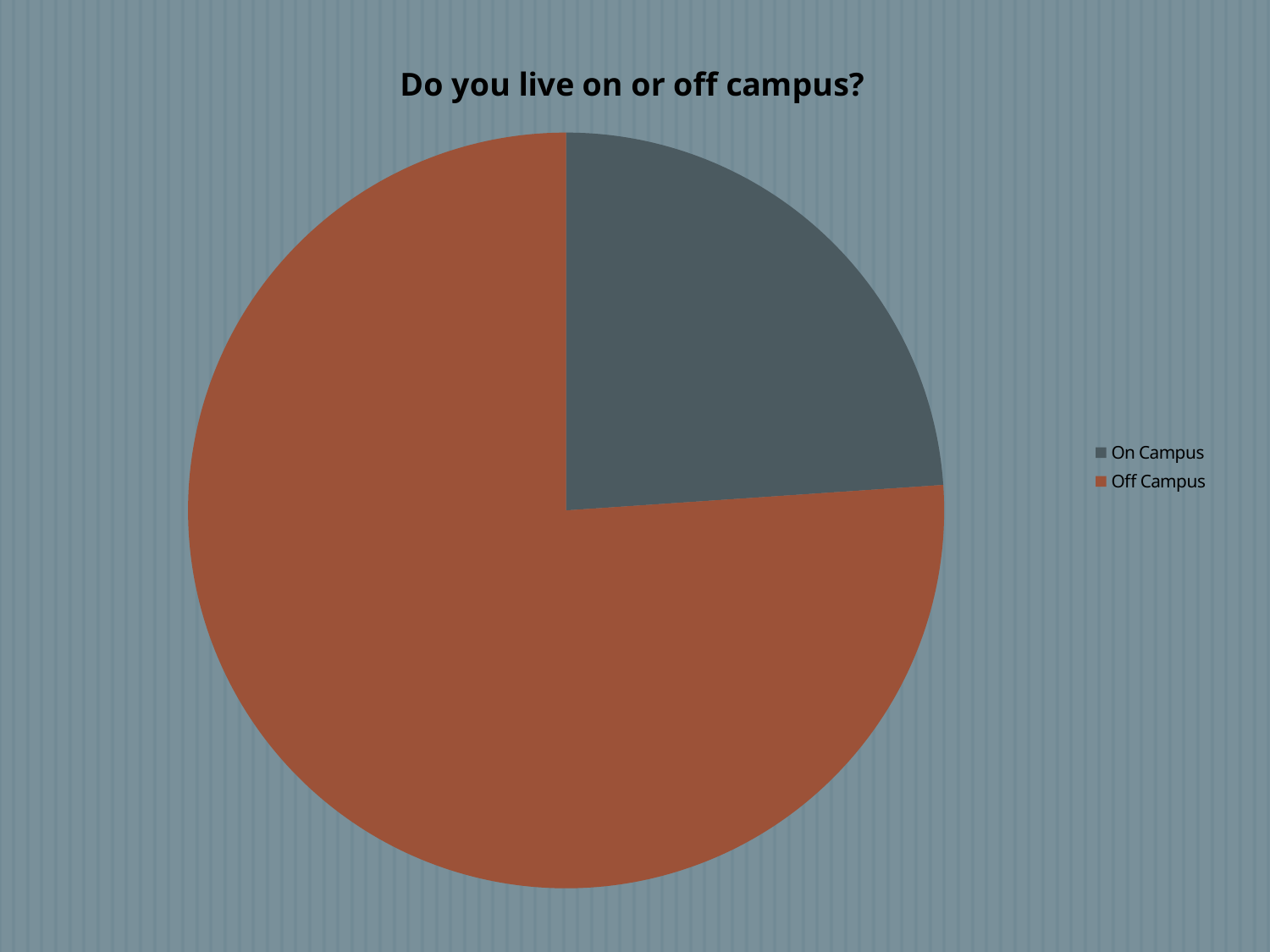
Which slice is larger, On Campus or Off Campus? Off Campus What kind of chart is shown on the slide? pie chart Is the Off Campus share of the pie greater or less than 50%? greater Is the On Campus share of the pie greater or less than 50%? less What is the title of the chart? Do you live on or off campus? Which category has the smallest slice of the pie? On Campus How many categories does the legend list? 2 What colour is the Off Campus slice? orange-brown Which category has the largest slice of the pie? Off Campus